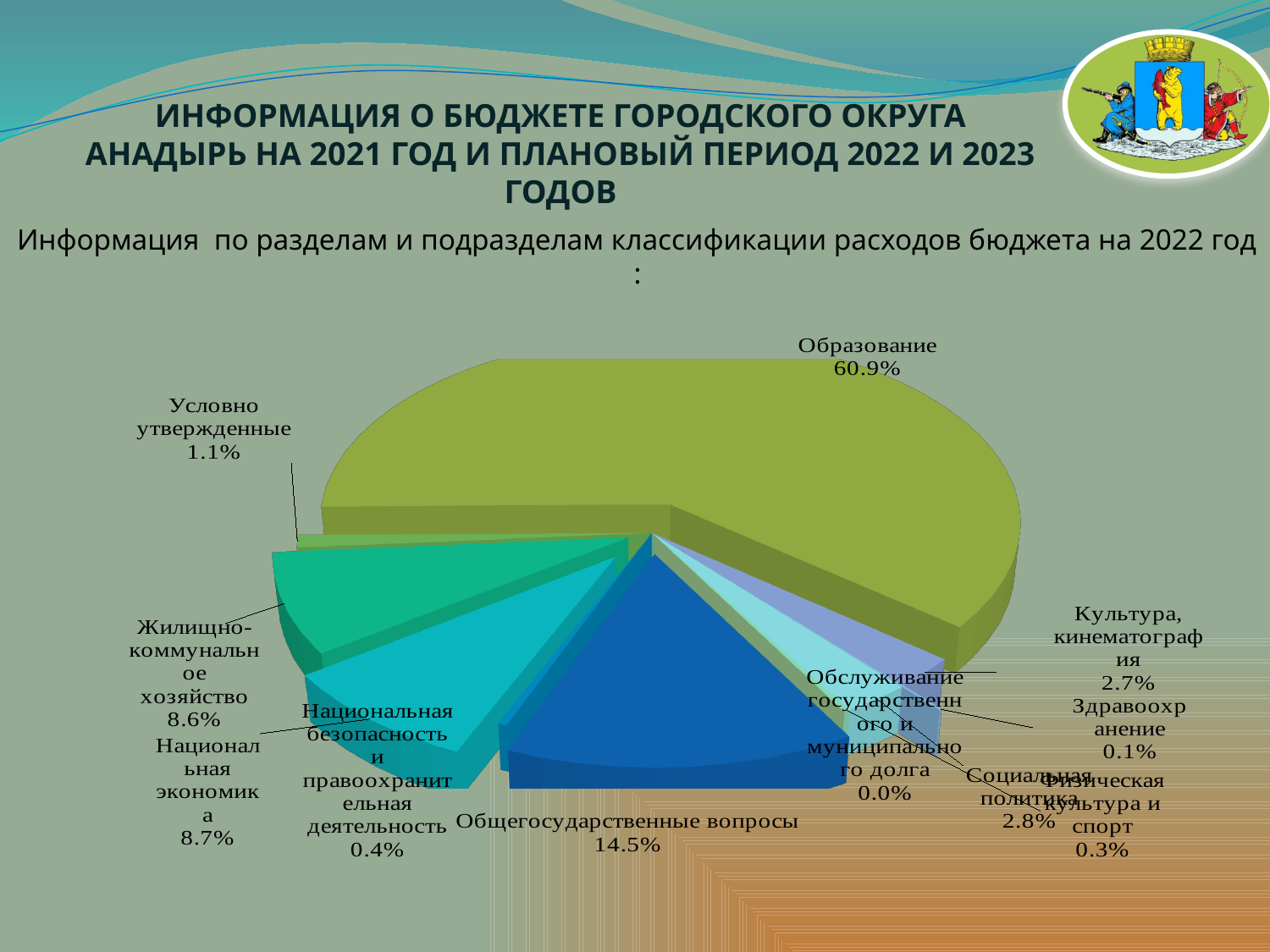
What share of the pie does Образование have? 60.9% What is the difference between the shares of Образование and Общегосударственные вопросы? 46.4% What is the difference between the shares of Социальная политика and Культура, кинематография? 0.1% What kind of chart is shown on the slide? pie chart How many categories are shown in the pie chart? 11 What is the value shown for Социальная политика? 2.8% What is the value shown for Жилищно-коммунальное хозяйство? 8.6% Which category has the smallest share of the pie? Обслуживание государственного и муниципального долга What is the value shown for Общегосударственные вопросы? 14.5% Which category has the largest share of the pie? Образование What is the value shown for Условно утвержденные? 1.1% Which is larger, the share of Национальная экономика or the share of Жилищно-коммунальное хозяйство? Национальная экономика